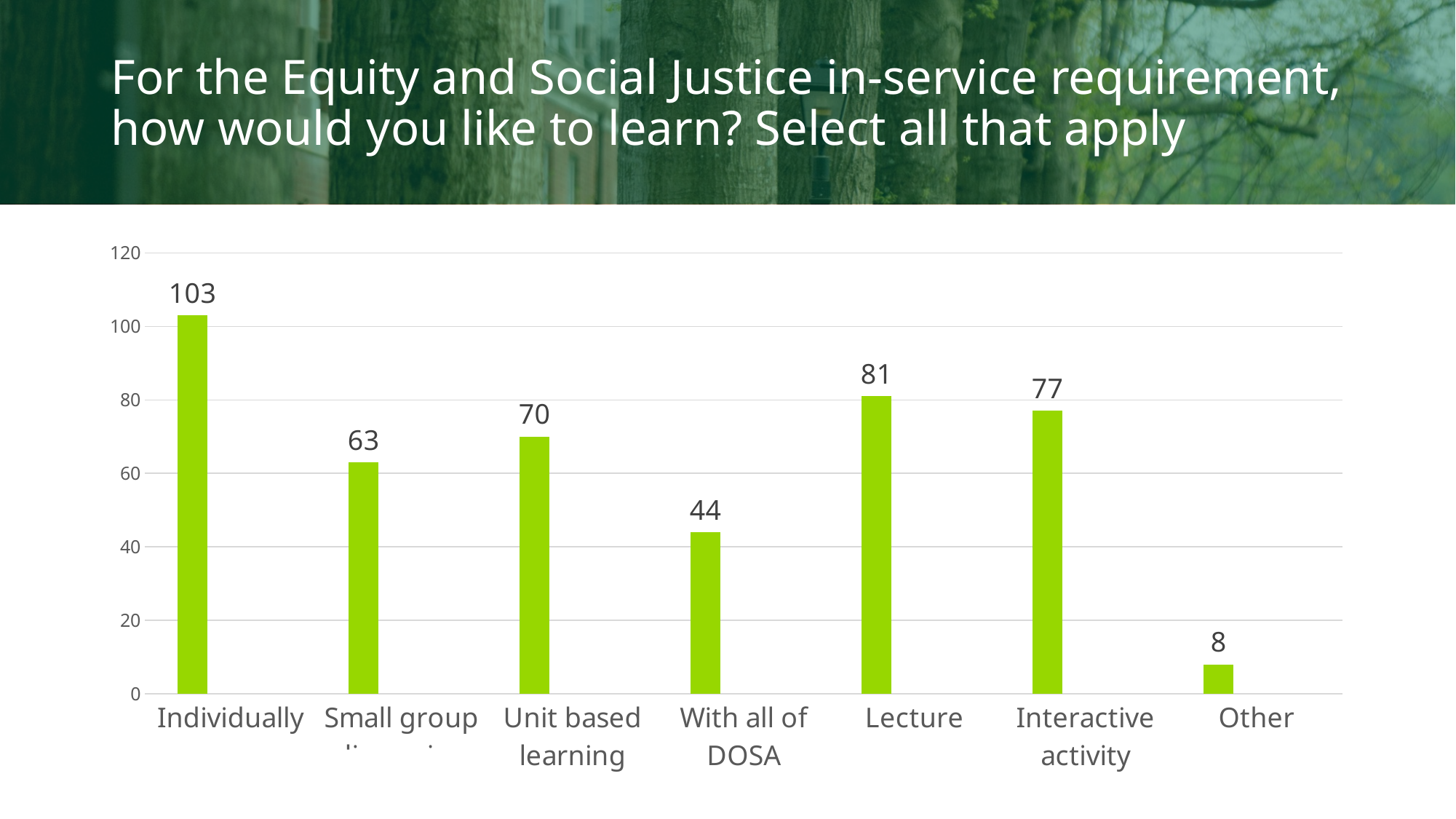
How many categories are shown on the x axis? 7 What is the value for Lecture? 81 Is the value for Unit based learning greater or less than 60? greater What kind of chart is shown on the slide? Bar chart What is the value for Interactive activity? 77 What is the difference between the values for Individually and Lecture? 22 Which category has the lowest value? Other Which category has the highest value? Individually What is the value for With all of DOSA? 44 What is the value for Individually? 103 Which is larger, the value for Lecture or the value for Interactive activity? Lecture What is the difference between the values for Unit based learning and With all of DOSA? 26